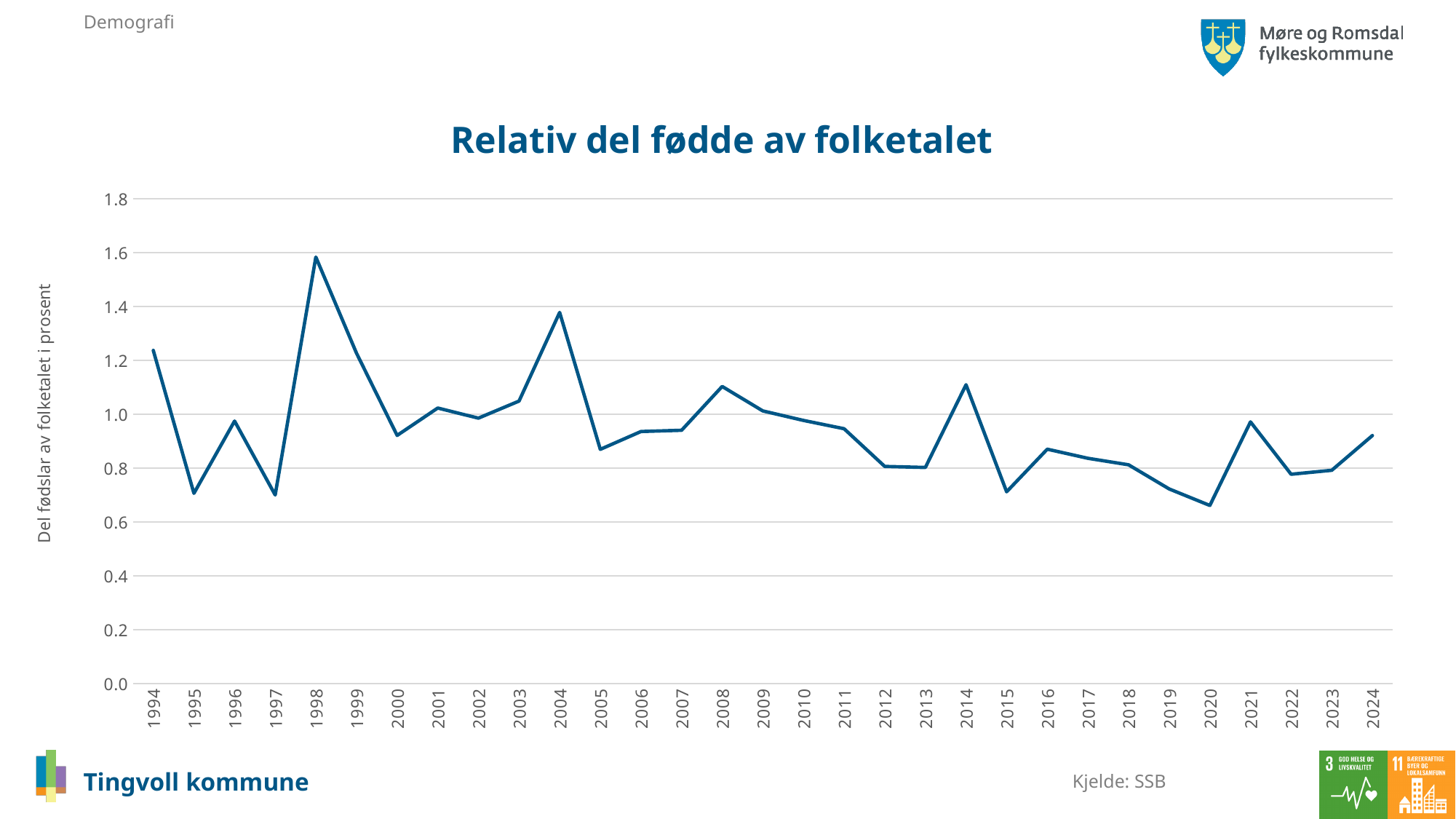
What is the label on the vertical axis of the chart? Del fødslar av folketalet i prosent Which year has the highest value in the chart? 1998 Which year has the larger value, 2014 or 2021? 2014 Is the value for 2012 greater or less than 1.0? less How many years are plotted along the x axis of the chart? 31 Is the value for 2004 greater or less than 1.2? greater What is the title of the chart? Relativ del fødde av folketalet Do the values rise or fall from 2014 to 2020? fall Is the value for 2020 greater or less than 0.8? less What kind of chart is shown on the slide? line chart Which year has the larger value, 1998 or 2004? 1998